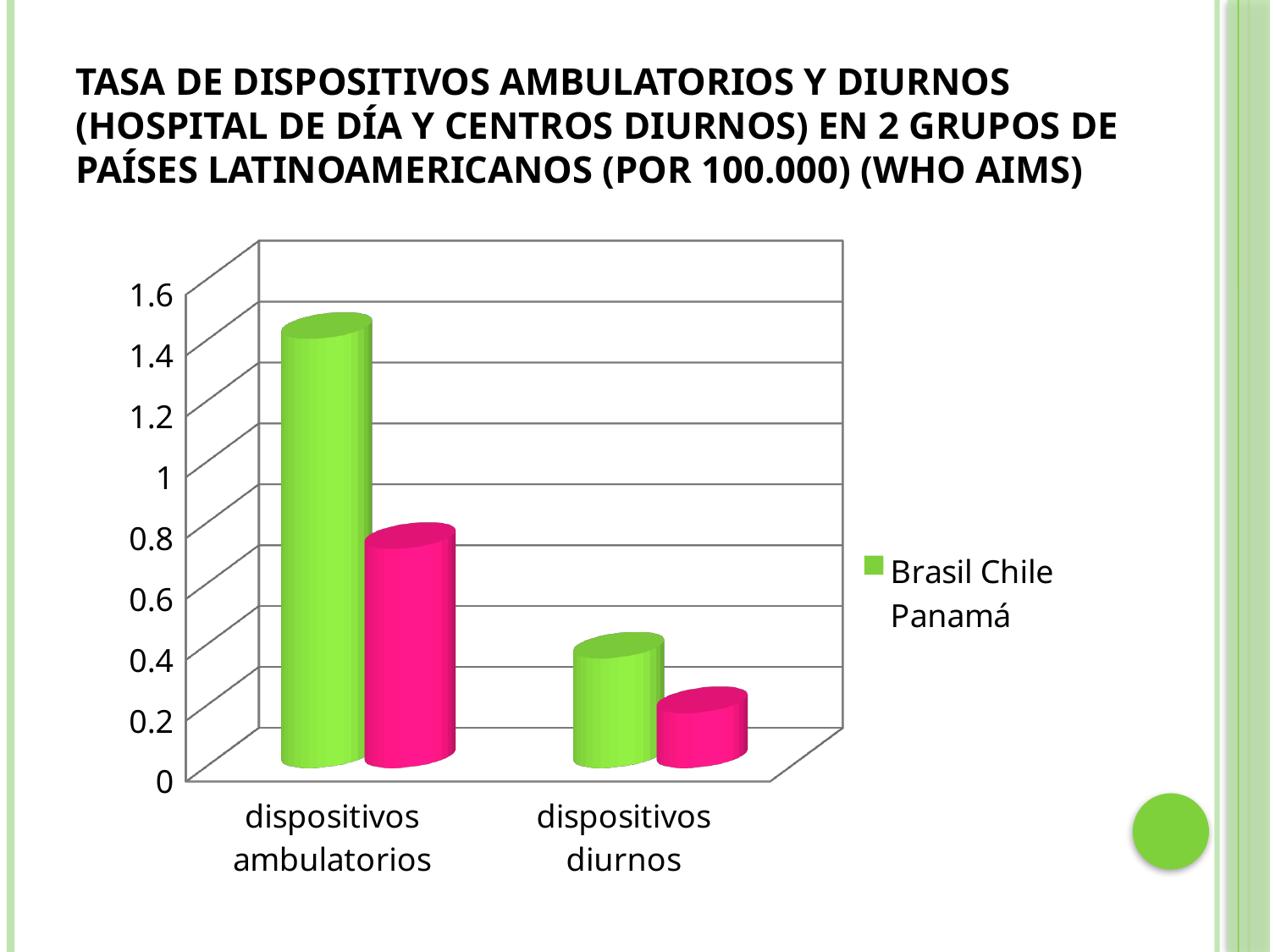
Which series does the green colour represent according to the legend? Brasil Chile Panamá Is the value of the pink bar for dispositivos ambulatorios greater or less than 1? less For dispositivos ambulatorios, which bar is taller, the green one or the pink one? the green one Which bar is the lowest in the chart? the pink bar for dispositivos diurnos How many categories are shown on the x axis of the chart? 2 Which category has the tallest bar in the chart? dispositivos ambulatorios Is the value of the green bar for dispositivos ambulatorios greater or less than 1? greater What is the highest value shown on the vertical axis of the chart? 1.6 Is the value of the green bar for dispositivos diurnos greater or less than 0.6? less What kind of chart is shown on the slide? bar chart Do the values rise or fall from dispositivos ambulatorios to dispositivos diurnos? fall